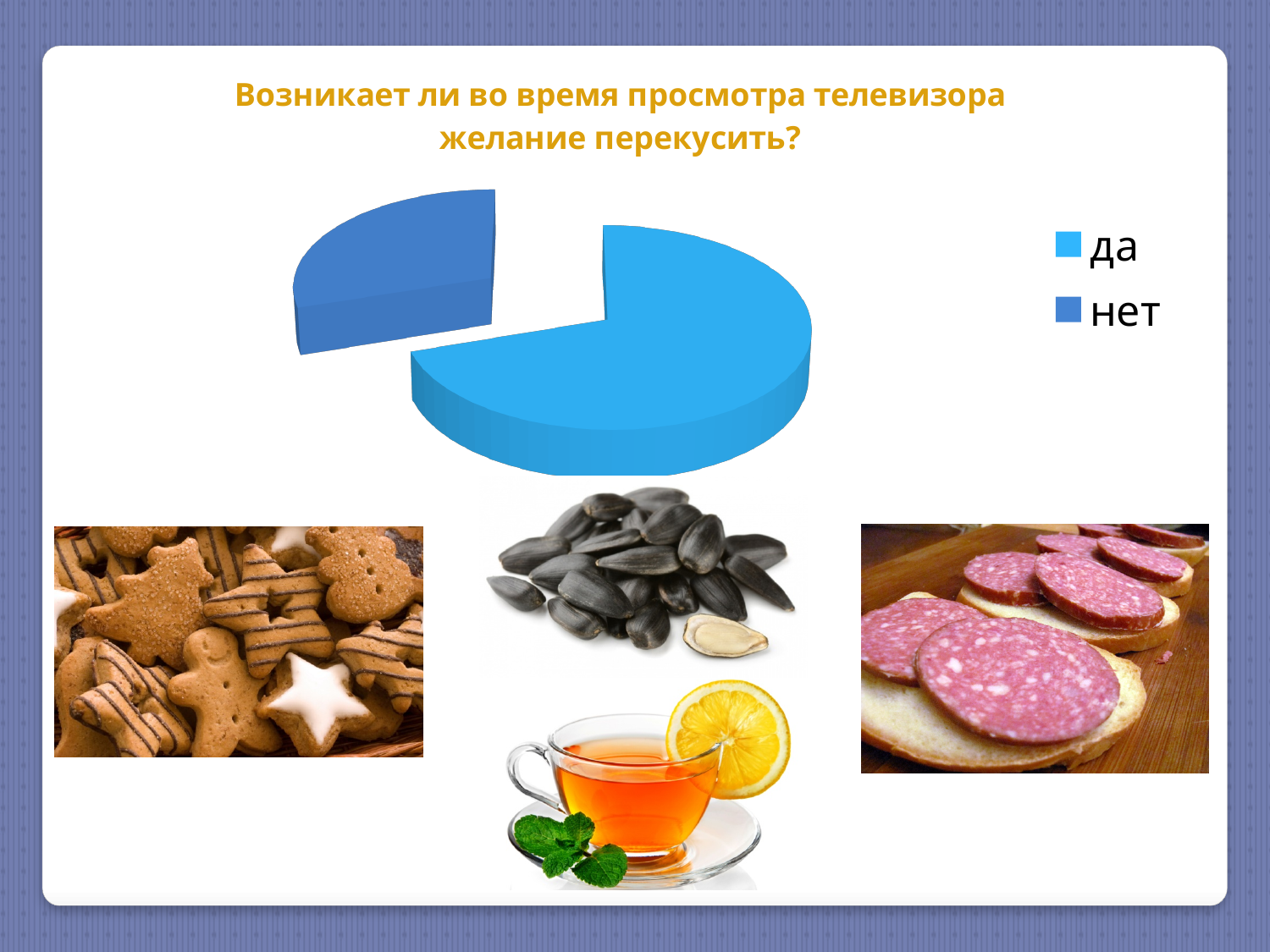
Which slice is larger in the pie chart, "да" or "нет"? да What kind of chart is shown on the slide? pie chart How many entries does the legend of the pie chart list? 2 Which category has the smallest slice in the pie chart? нет Does the "да" slice take up more or less than half of the pie chart? more Which category has the largest slice in the pie chart? да How many slices does the pie chart have? 2 What is the title of the chart on the slide? Возникает ли во время просмотра телевизора желание перекусить? What are the two legend entries of the pie chart? да, нет